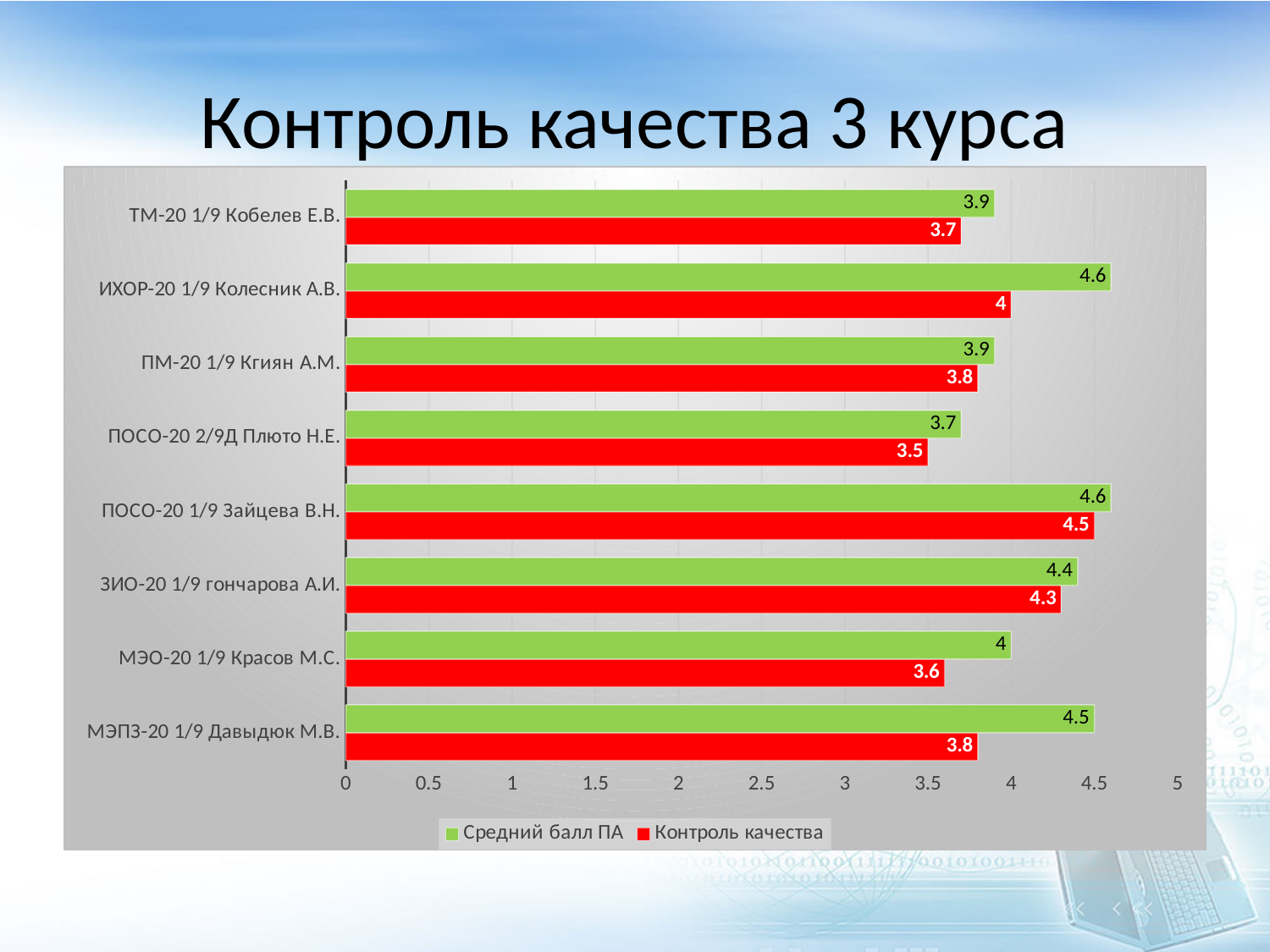
How many categories are shown on the chart? 8 What kind of chart is shown on the slide? Bar chart What is the Контроль качества value for МЭО-20 1/9 Красов М.С.? 3.6 Which category has the lowest Средний балл ПА value? ПОСО-20 2/9Д Плюто Н.Е. What is the difference between Средний балл ПА and Контроль качества for МЭПЗ-20 1/9 Давыдюк М.В.? 0.7 How many series does the legend list? 2 Which is larger for ИХОР-20 1/9 Колесник А.В.: Средний балл ПА or Контроль качества? Средний балл ПА What is the Средний балл ПА value for МЭПЗ-20 1/9 Давыдюк М.В.? 4.5 What is the Контроль качества value for ИХОР-20 1/9 Колесник А.В.? 4 Which category has the lowest Контроль качества value? ПОСО-20 2/9Д Плюто Н.Е. Which colour represents the Контроль качества series? Red Which category has the highest Контроль качества value? ПОСО-20 1/9 Зайцева В.Н.